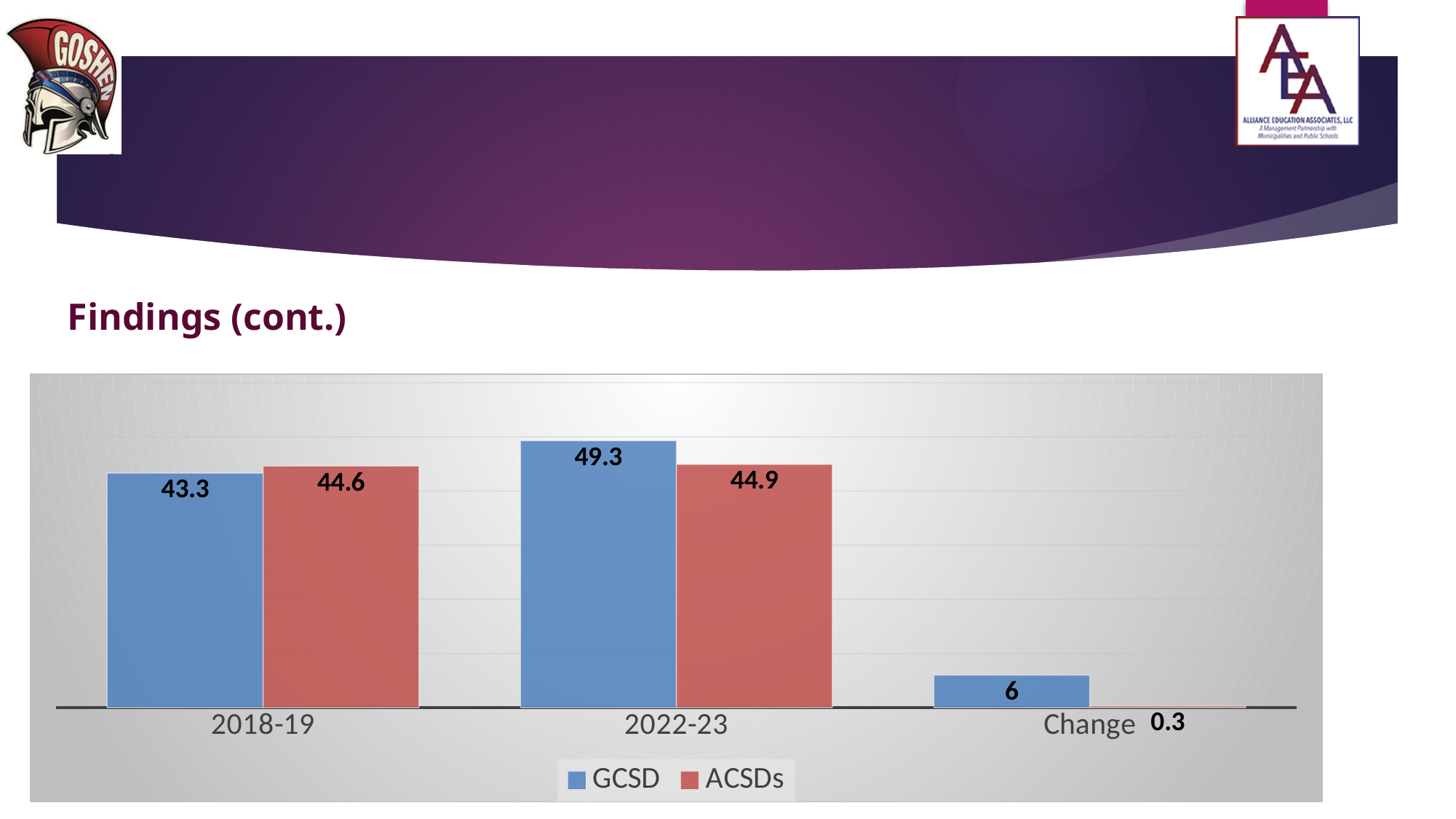
Which is larger for 2018-19, GCSD or ACSDs? ACSDs What is the difference between the GCSD and ACSDs values for 2022-23? 4.4 Which category has the lowest ACSDs value? Change What is the ACSDs value for Change? 0.3 Which category has the highest GCSD value? 2022-23 What is the GCSD value for 2018-19? 43.3 What is the GCSD value for Change? 6 What kind of chart is shown on the slide? Bar chart How many series does the legend list? 2 How many categories are shown on the x axis? 3 What is the ACSDs value for 2022-23? 44.9 What colour are the GCSD bars? Blue